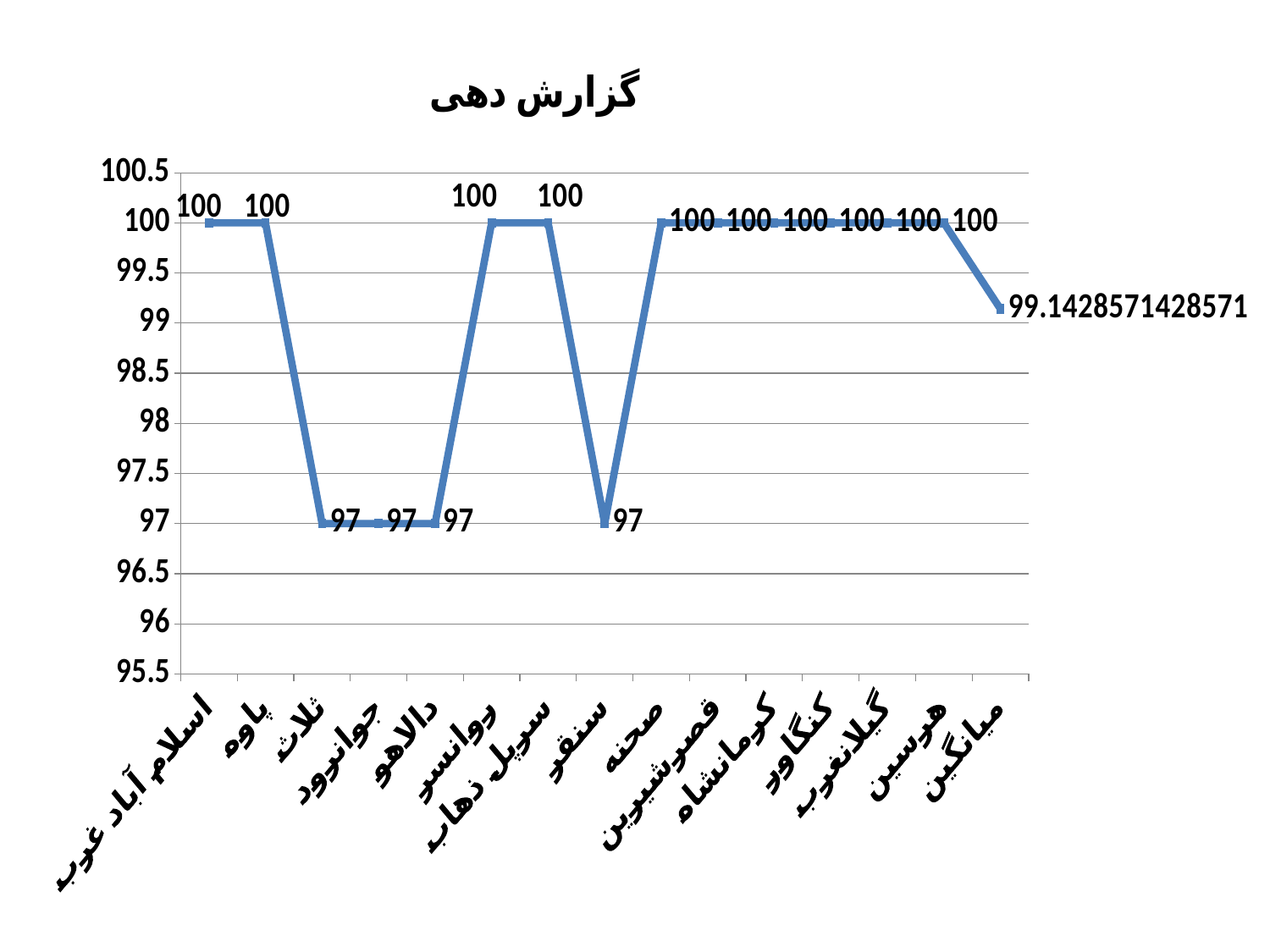
What is the value for ثلاث? 97 What is the value for سنقر? 97 What is the value for کرمانشاه? 100 Which is larger, the value for صحنه or the value for جوانرود? صحنه How many categories are plotted along the x axis? 15 What is the value for میانگین? 99.1428571428571 What is the title of the chart? گزارش دهی What is the value for پاوه? 100 Is the value for میانگین greater or less than 99.5? less What is the difference between the value for روانسر and the value for دالاهو? 3 Does the line rise or fall between هرسین and میانگین? fall What type of chart is shown on the slide? line chart